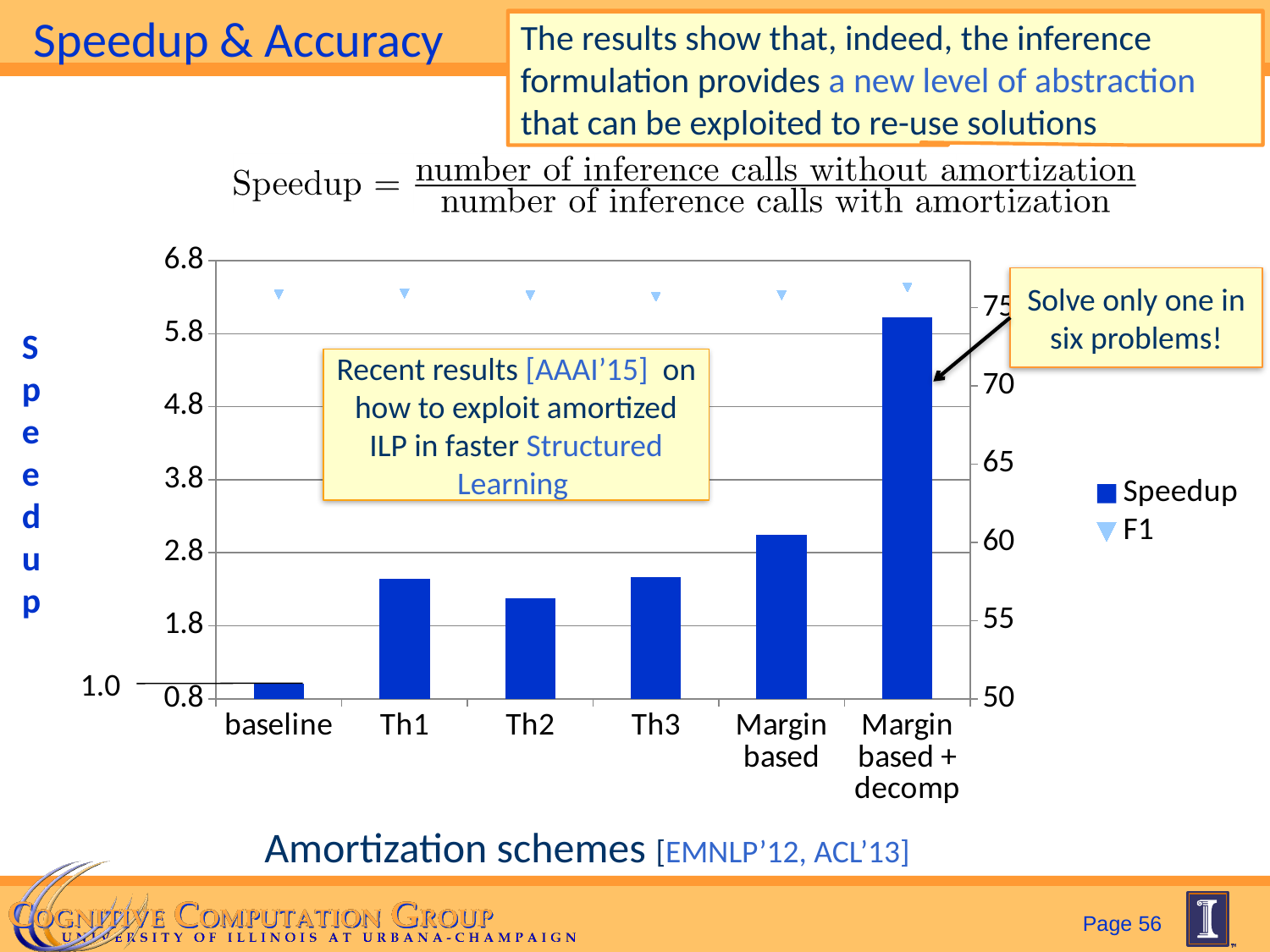
Which has a larger Speedup, Th1 or Th2? Th1 Is the Speedup value for Margin based + decomp greater or less than 4.8? greater What kind of chart is shown on the slide? bar chart Is the Speedup value for baseline greater or less than 1.8? less Which amortization scheme has the highest Speedup bar? Margin based + decomp Which amortization scheme has the lowest Speedup bar? baseline How many series does the chart legend list? 2 What is the label of the x axis of the chart? Amortization schemes How many amortization schemes (categories) are shown on the x axis of the chart? 6 Is the Speedup value for Th2 greater or less than 2.8? less Which series are listed in the chart legend? Speedup and F1 Which has a larger Speedup, Margin based or Th3? Margin based